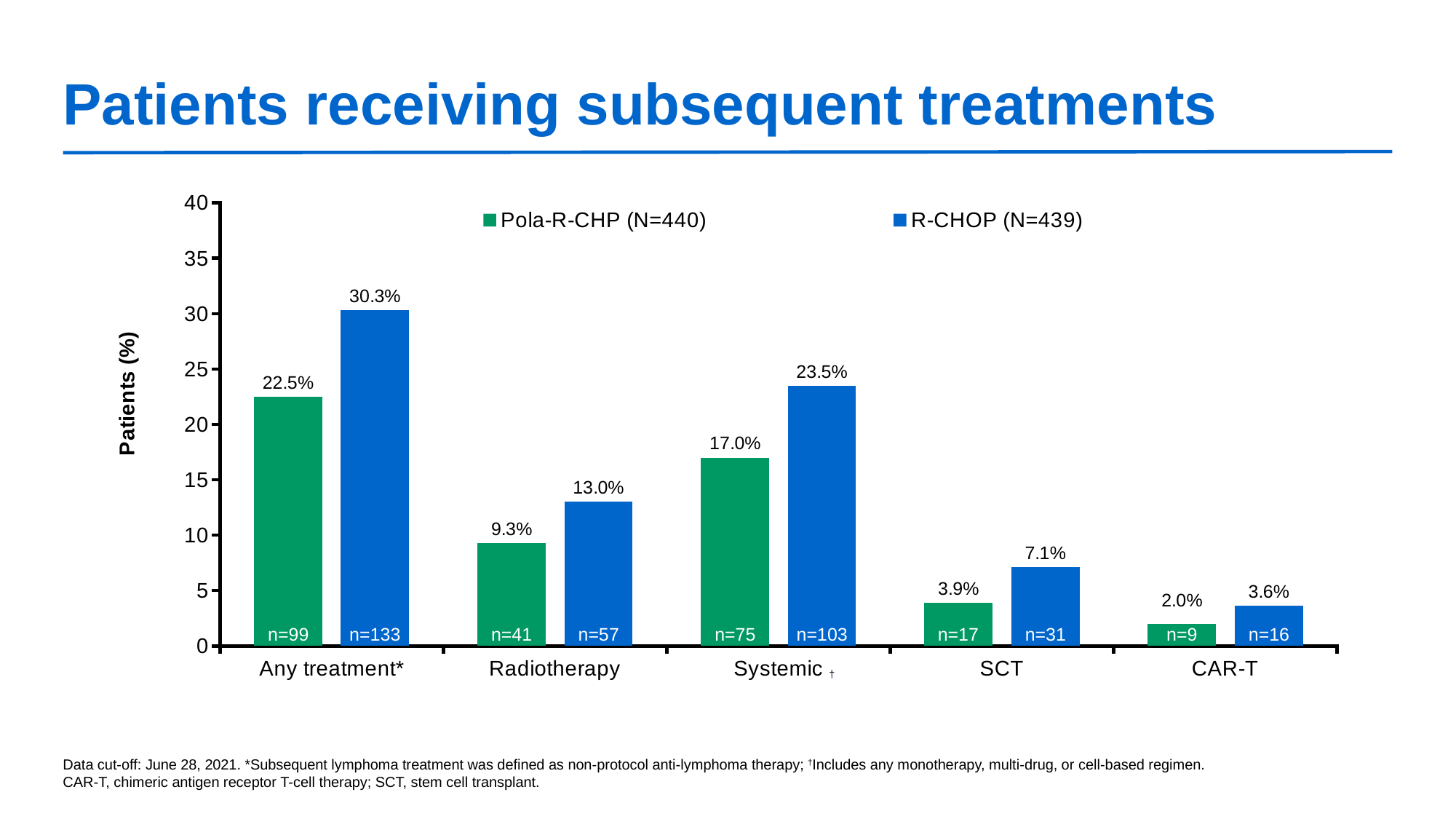
What is the difference in percentage between R-CHOP and Pola-R-CHP for any treatment? 7.8% How many series does the legend list? 2 What percentage of R-CHOP patients received systemic subsequent treatment? 23.5% Which treatment category has the lowest percentage for Pola-R-CHP? CAR-T How many R-CHOP patients received radiotherapy (n)? n=57 What kind of chart is shown on the slide? Bar chart What is the label of the y axis? Patients (%) What percentage of Pola-R-CHP patients received any subsequent treatment? 22.5% How many treatment categories are shown on the x axis? 5 What is the difference in percentage between R-CHOP and Pola-R-CHP for CAR-T? 1.6% Which arm has the larger percentage of patients receiving SCT, Pola-R-CHP or R-CHOP? R-CHOP Which treatment category has the highest percentage for R-CHOP? Any treatment*